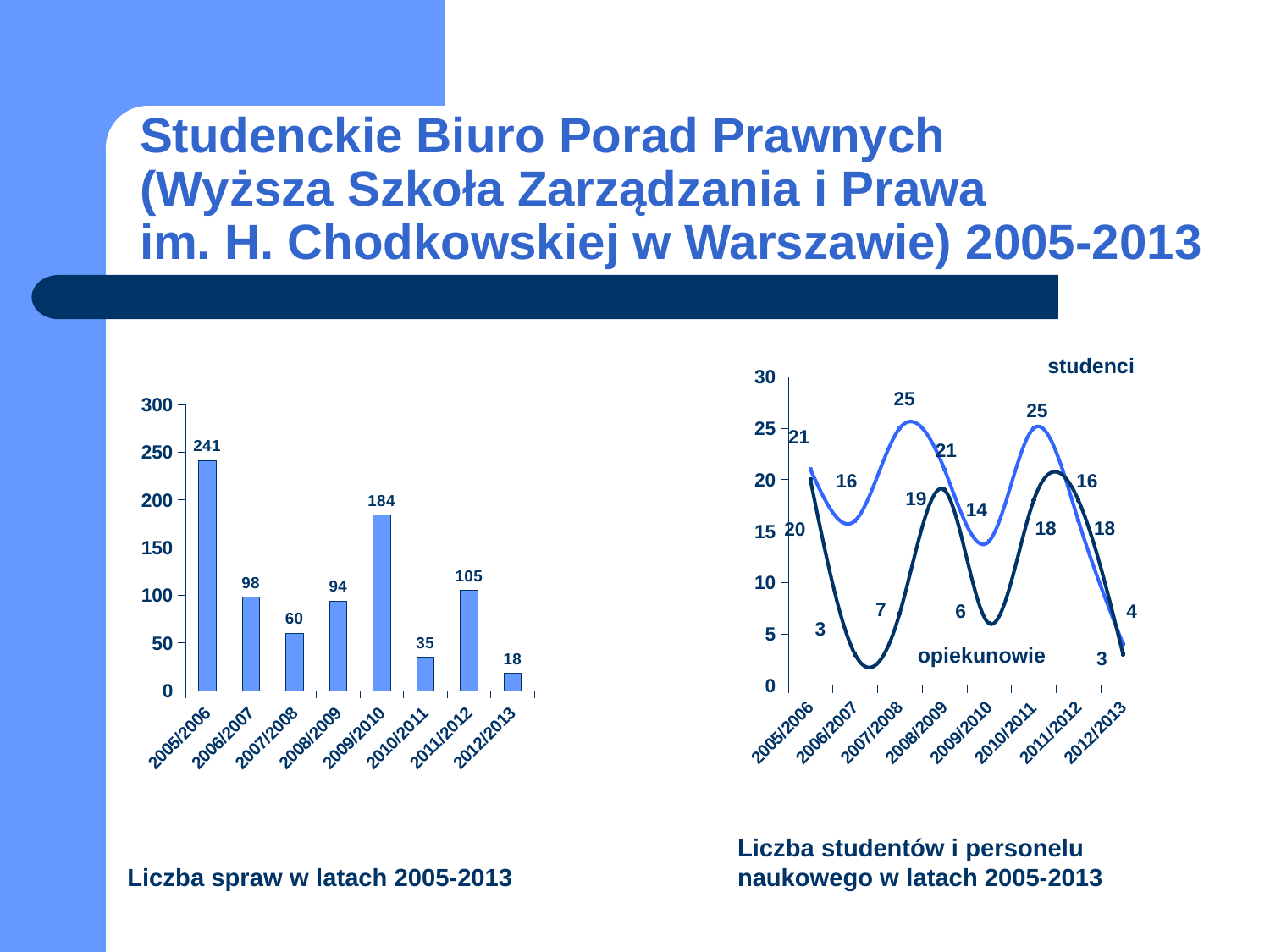
In the left chart (Liczba spraw w latach 2005-2013), what is the value for 2005/2006? 241 In the left chart (Liczba spraw w latach 2005-2013), what is the difference between the values for 2005/2006 and 2009/2010? 57 What type of chart is the left chart (Liczba spraw w latach 2005-2013)? bar chart In the right chart (Liczba studentów i personelu naukowego w latach 2005-2013), what is the value for studenci in 2012/2013? 4 In the left chart (Liczba spraw w latach 2005-2013), which year has the highest value? 2005/2006 In the left chart (Liczba spraw w latach 2005-2013), which year has the lowest value? 2012/2013 In the left chart (Liczba spraw w latach 2005-2013), which is larger, the value for 2006/2007 or 2008/2009? 2006/2007 In the right chart (Liczba studentów i personelu naukowego w latach 2005-2013), what is the value for studenci in 2007/2008? 25 In the right chart (Liczba studentów i personelu naukowego w latach 2005-2013), what are the two series shown? studenci and opiekunowie What type of chart is the right chart (Liczba studentów i personelu naukowego w latach 2005-2013)? line chart In the left chart (Liczba spraw w latach 2005-2013), how many years are shown on the x axis? 8 In the left chart (Liczba spraw w latach 2005-2013), what is the value for 2009/2010? 184